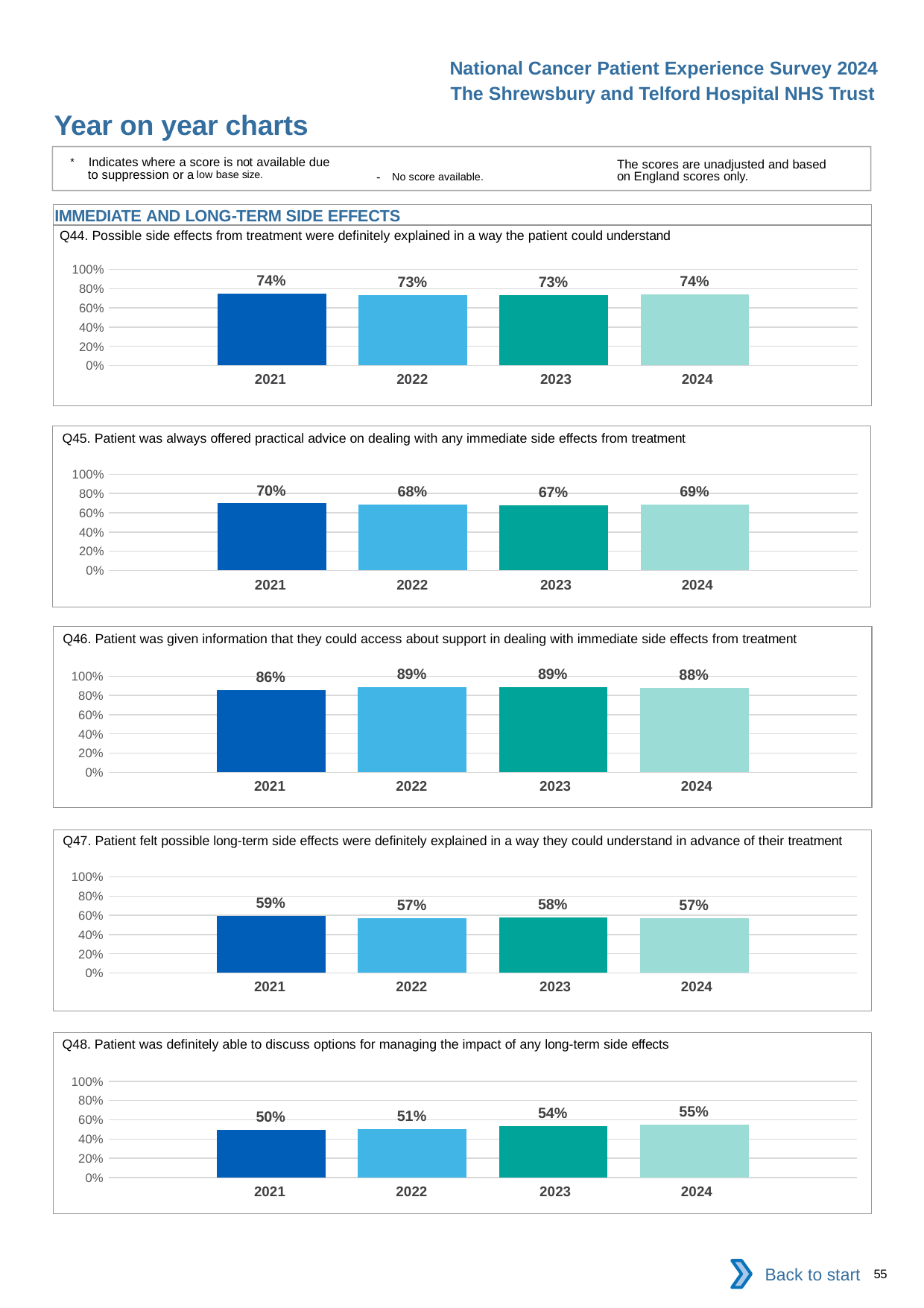
In the Q47 chart, which year has the highest value? 2021 In the Q46 chart, is the value for 2022 larger or smaller than the value for 2021? larger In the Q47 chart, is the value for 2024 greater or less than 60%? less What type of chart is used for Q44? bar chart In the Q45 chart, what is the difference between the 2021 and 2023 values? 3 percentage points How many charts are shown on the slide? 5 In the Q48 chart, do the values rise or fall from 2021 to 2024? rise In the Q44 chart, what is the value for 2024? 74% In the Q45 chart, which year has the lowest value? 2023 In the Q48 chart, what is the difference between the 2024 and 2021 values? 5 percentage points How many years are shown in the Q48 chart? 4 In the Q46 chart, what is the value for 2021? 86%